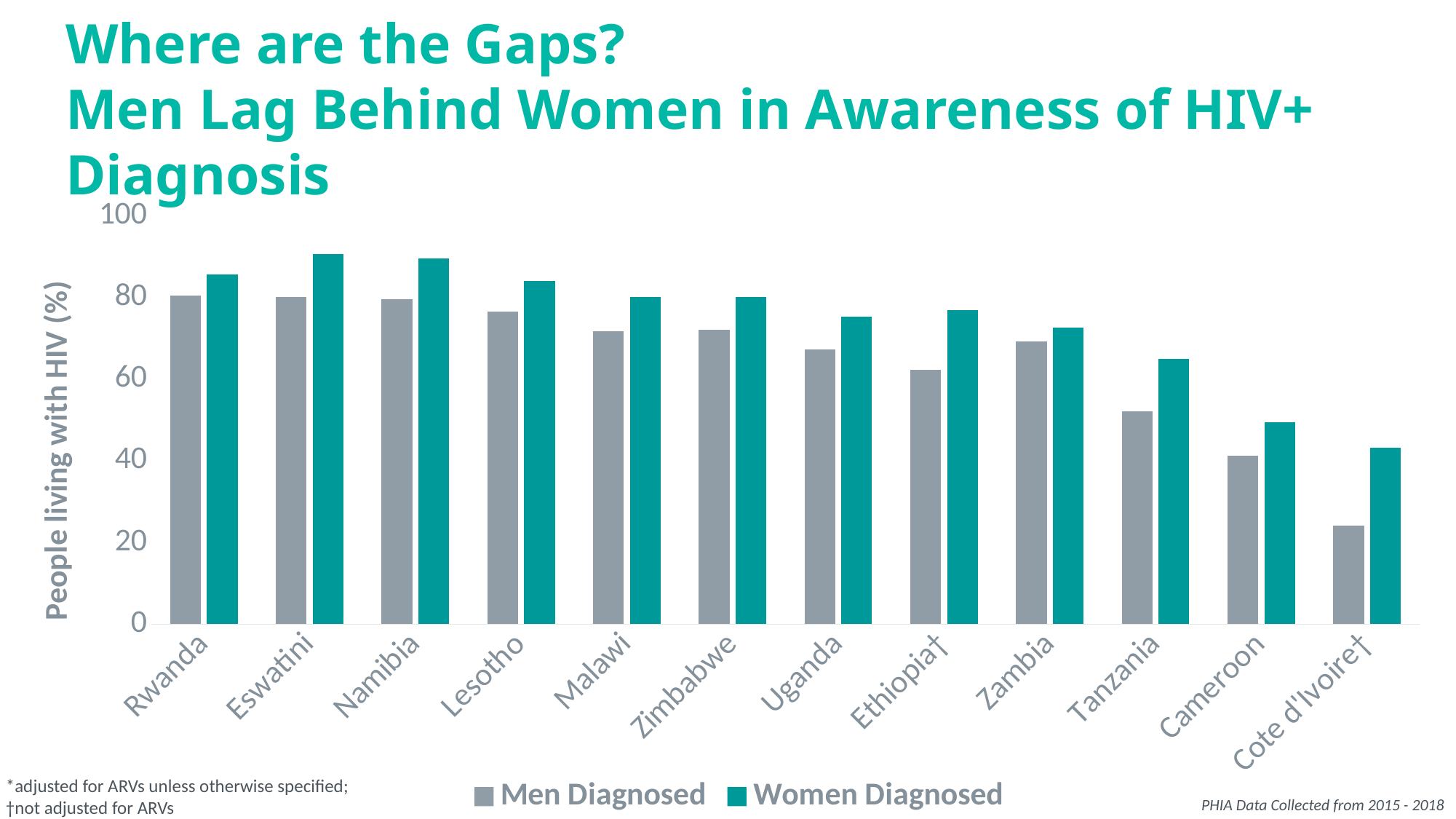
Which is larger: the Men Diagnosed value for Tanzania or for Cameroon? Tanzania Is the Women Diagnosed value for Cameroon greater or less than 60? less Which country has the lowest value for Men Diagnosed? Cote d'Ivoire† How many countries are shown on the x axis of the chart? 12 What is the label of the vertical axis of the chart? People living with HIV (%) Which country has the lowest value for Women Diagnosed? Cote d'Ivoire† Is the Men Diagnosed value for Tanzania greater or less than 40? greater Is the Women Diagnosed value for Eswatini greater or less than 80? greater How many series does the chart's legend list? 2 Do the Women Diagnosed values generally rise or fall moving from Rwanda to Cote d'Ivoire† along the x axis? fall What kind of chart is shown on the slide? Bar chart